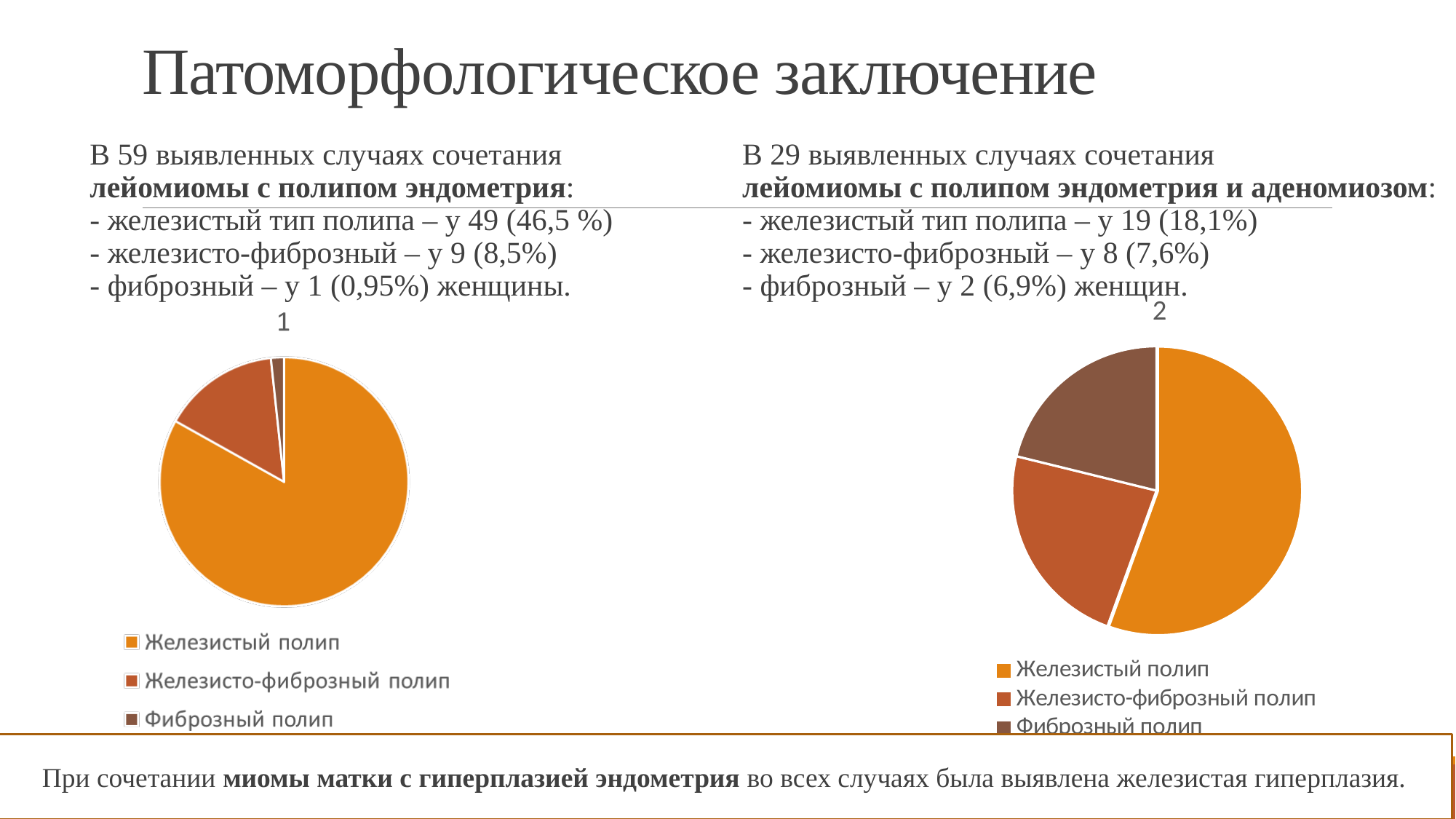
In the chart titled "2", which slice is larger: Железистый полип or Железисто-фиброзный полип? Железистый полип What kind of chart is the chart titled "2" on the right of the slide? Pie chart In the chart titled "1", how many slices does the pie have? 3 In the chart titled "1", which category has the smallest slice? Фиброзный полип In the chart titled "2", what colour is the slice for Железистый полип? Orange In the chart titled "2", how many entries does the legend list? 3 In the chart titled "2", which category has the largest slice? Железистый полип What is the title of the pie chart on the left of the slide? 1 What kind of chart is the chart titled "1" on the left of the slide? Pie chart In the chart titled "1", which category has the largest slice? Железистый полип In the chart titled "1", which slice is larger: Железисто-фиброзный полип or Фиброзный полип? Железисто-фиброзный полип